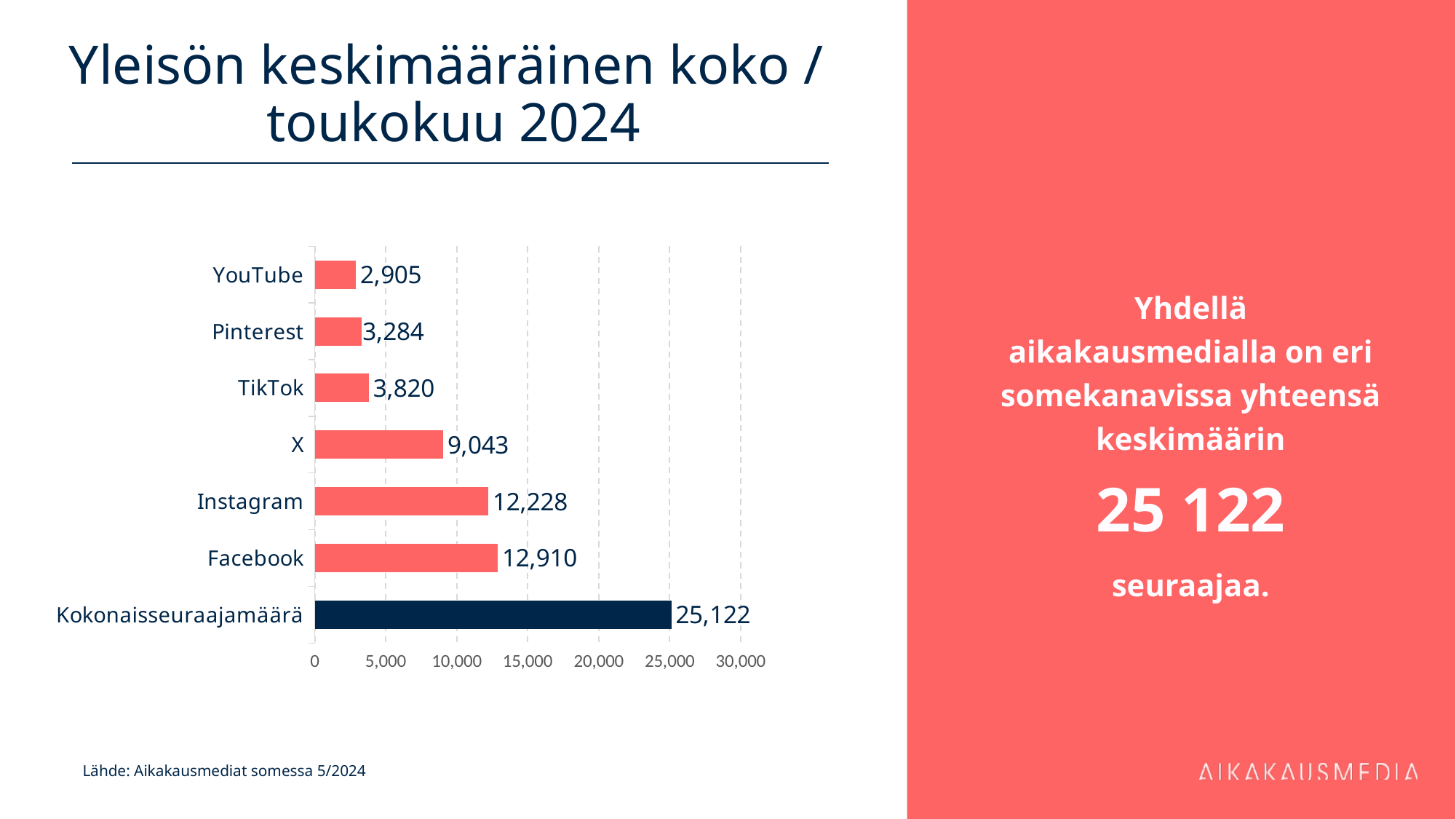
Which is larger, the value for Pinterest or the value for YouTube? Pinterest What is the value for Kokonaisseuraajamäärä? 25,122 Which category has the lowest value? YouTube What is the value for TikTok? 3,820 What is the difference between the values for Facebook and Instagram? 682 What is the title of the slide? Yleisön keskimääräinen koko / toukokuu 2024 What is the difference between the values for X and TikTok? 5,223 How many categories are shown in the chart? 7 Which category has the highest value? Kokonaisseuraajamäärä What kind of chart is shown on the slide? bar chart Is the value for X greater or less than 10,000? less What is the value for Facebook? 12,910